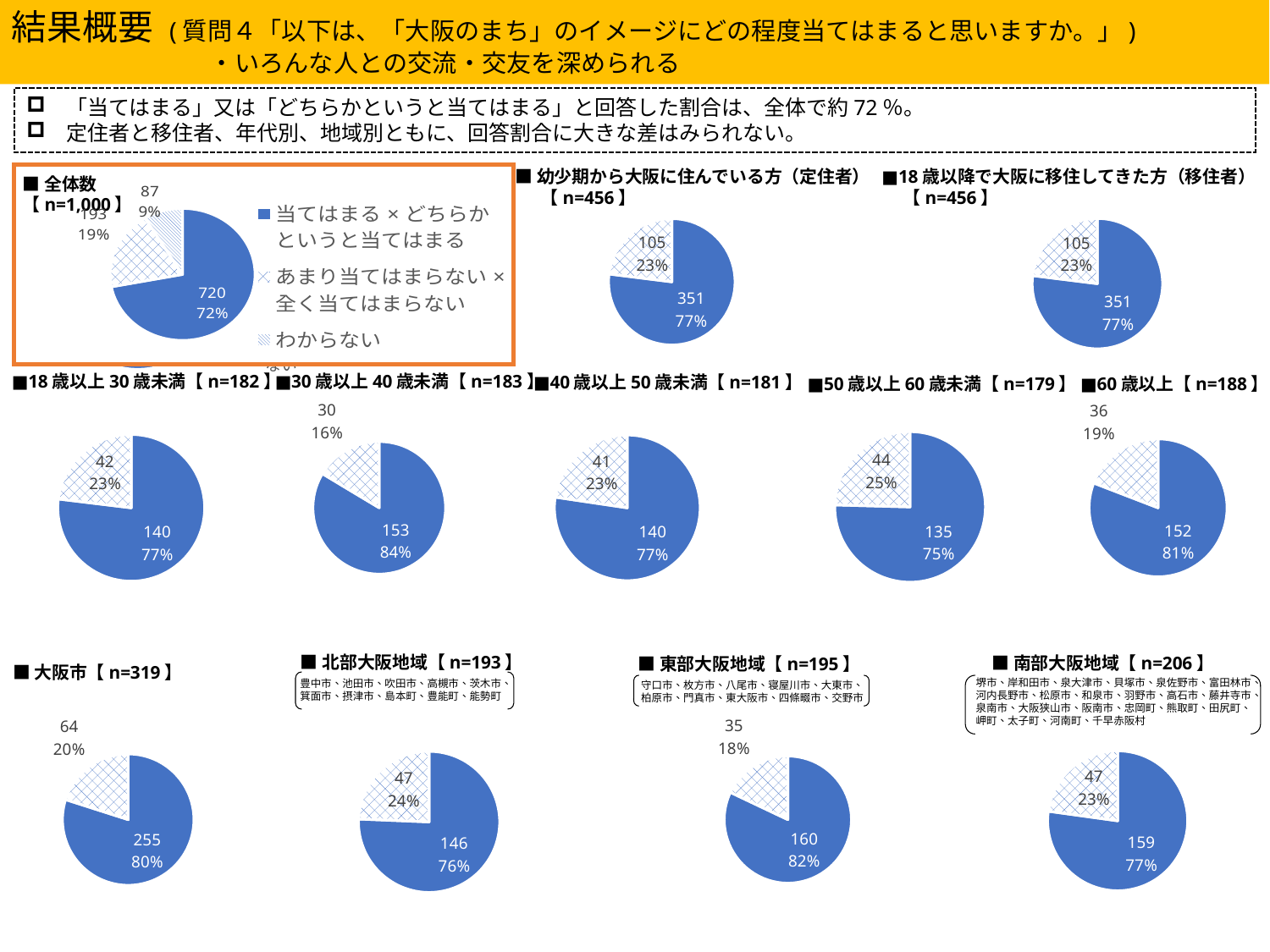
「全体数【n=1,000】」の円グラフで、「当てはまる×どちらかというと当てはまる」の割合は何%ですか。 72% 「30歳以上40歳未満【n=183】」の円グラフで、大きい方の扇形の割合は何%ですか。 84% 年代別の5つの円グラフのうち、大きい方の扇形の割合が最も高いのはどの年代ですか。 30歳以上40歳未満 「東部大阪地域【n=195】」の円グラフで、大きい方の扇形の回答数はいくつですか。 160 「幼少期から大阪に住んでいる方（定住者）【n=456】」の円グラフで、351と105の差はいくつですか。 246 「北部大阪地域【n=193】」と「南部大阪地域【n=206】」の円グラフで、大きい方の扇形の割合が高いのはどちらですか。 南部大阪地域 「全体数【n=1,000】」の円グラフの凡例には、いくつの項目がありますか。 3 「大阪市【n=319】」の円グラフで、大きい方の扇形の割合は何%ですか。 80% 「50歳以上60歳未満【n=179】」の円グラフで、小さい方の扇形の回答数はいくつですか。 44 このスライドのグラフはどの種類のグラフですか。 円グラフ 「全体数【n=1,000】」の円グラフで、最も割合が小さい項目はどれですか。 わからない 「全体数【n=1,000】」の円グラフで、「わからない」の回答数はいくつですか。 87